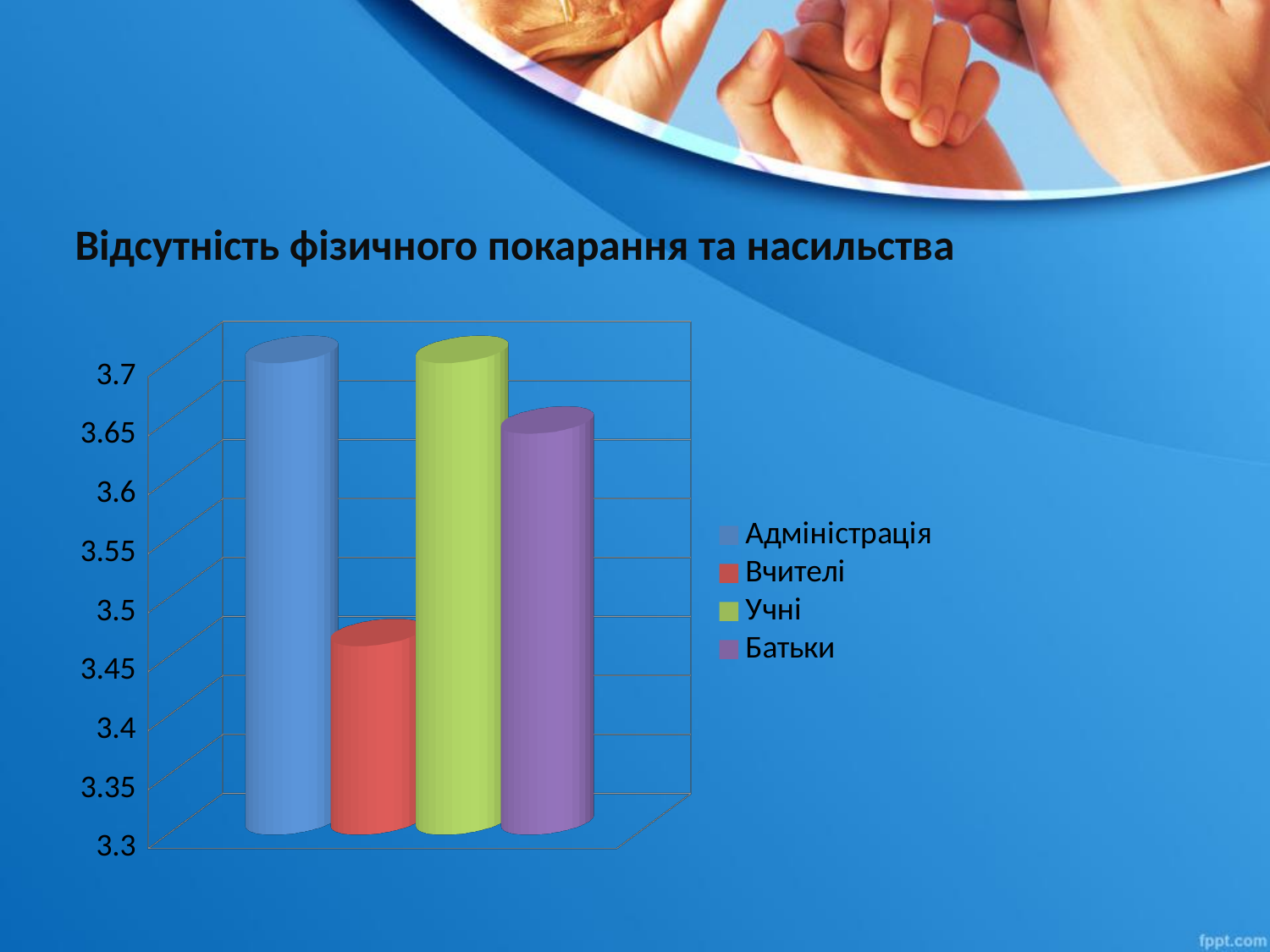
What colour is the bar for Учні? green Which is larger, the value for Батьки or the value for Вчителі? Батьки Is the value for Батьки greater or less than 3.6? greater How many bars are plotted in the chart? 4 Which series has the lowest value? Вчителі Is the value for Адміністрація greater or less than 3.6? greater What kind of chart is shown on the slide? bar chart Is the value for Вчителі greater or less than 3.5? less How many series does the legend list? 4 What is the title of the chart? Відсутність фізичного покарання та насильства Which is larger, the value for Учні or the value for Батьки? Учні